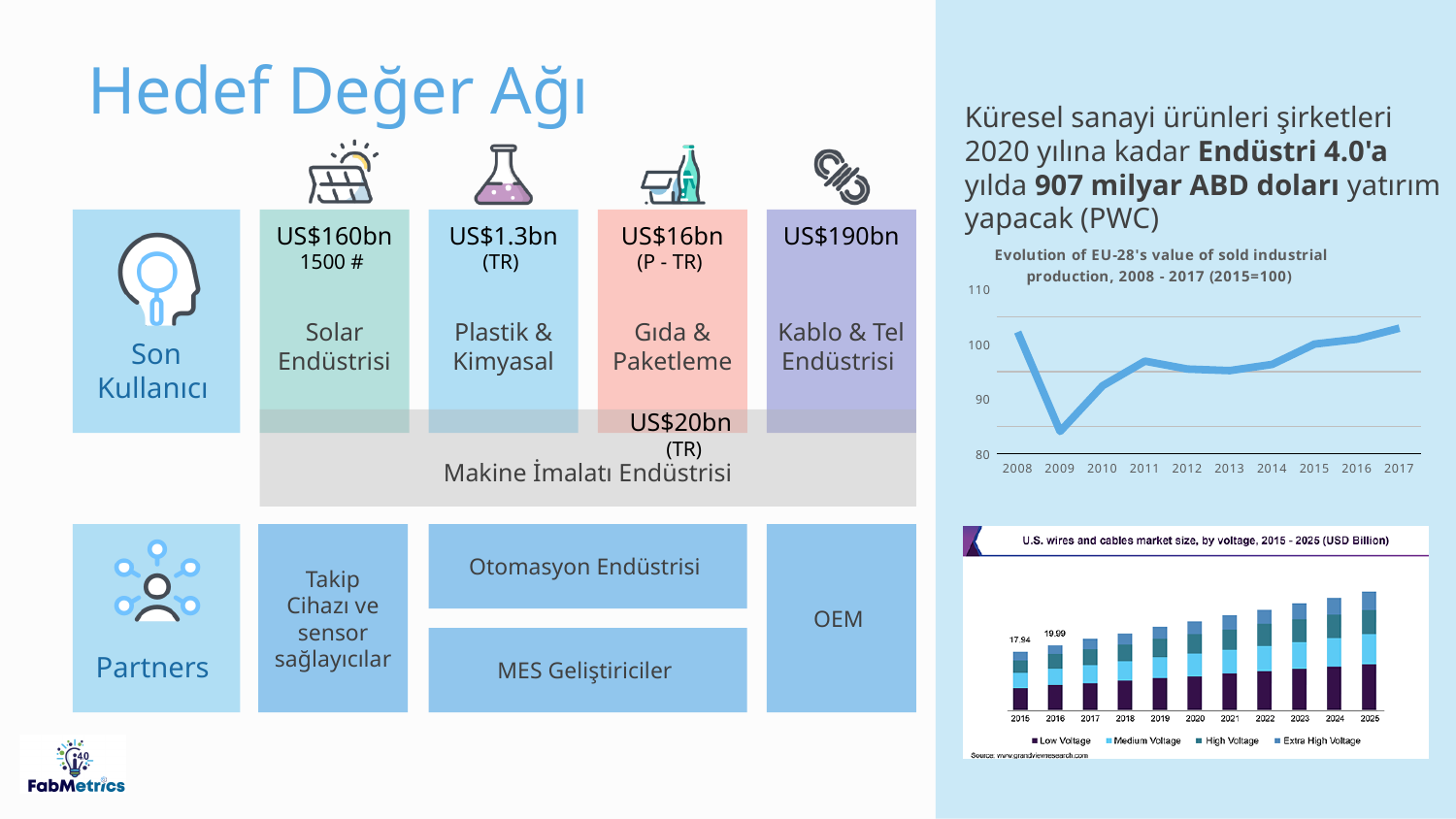
In the 'U.S. wires and cables market size, by voltage' chart, what is the total market size labelled for 2015? 17.94 In the 'U.S. wires and cables market size, by voltage' chart, do the bar totals rise or fall from 2015 to 2025? rise In the 'Evolution of EU-28's value of sold industrial production' chart, is the value for 2017 greater or less than 100? greater What kind of chart is the 'U.S. wires and cables market size, by voltage' chart? stacked bar chart In the 'Evolution of EU-28's value of sold industrial production' chart, which year has the lowest value? 2009 In the 'U.S. wires and cables market size, by voltage' chart, what is the total market size labelled for 2016? 19.99 In the 'Evolution of EU-28's value of sold industrial production' chart, is the value for 2011 greater or less than 100? less How many years are plotted on the x axis of the 'Evolution of EU-28's value of sold industrial production' chart? 10 In the 'Evolution of EU-28's value of sold industrial production' chart, is the value for 2009 greater or less than 90? less How many series does the legend of the 'U.S. wires and cables market size, by voltage' chart list? 4 In the 'U.S. wires and cables market size, by voltage' chart, what is the difference between the labelled totals for 2016 and 2015? 2.05 What kind of chart is the 'Evolution of EU-28's value of sold industrial production' chart? line chart